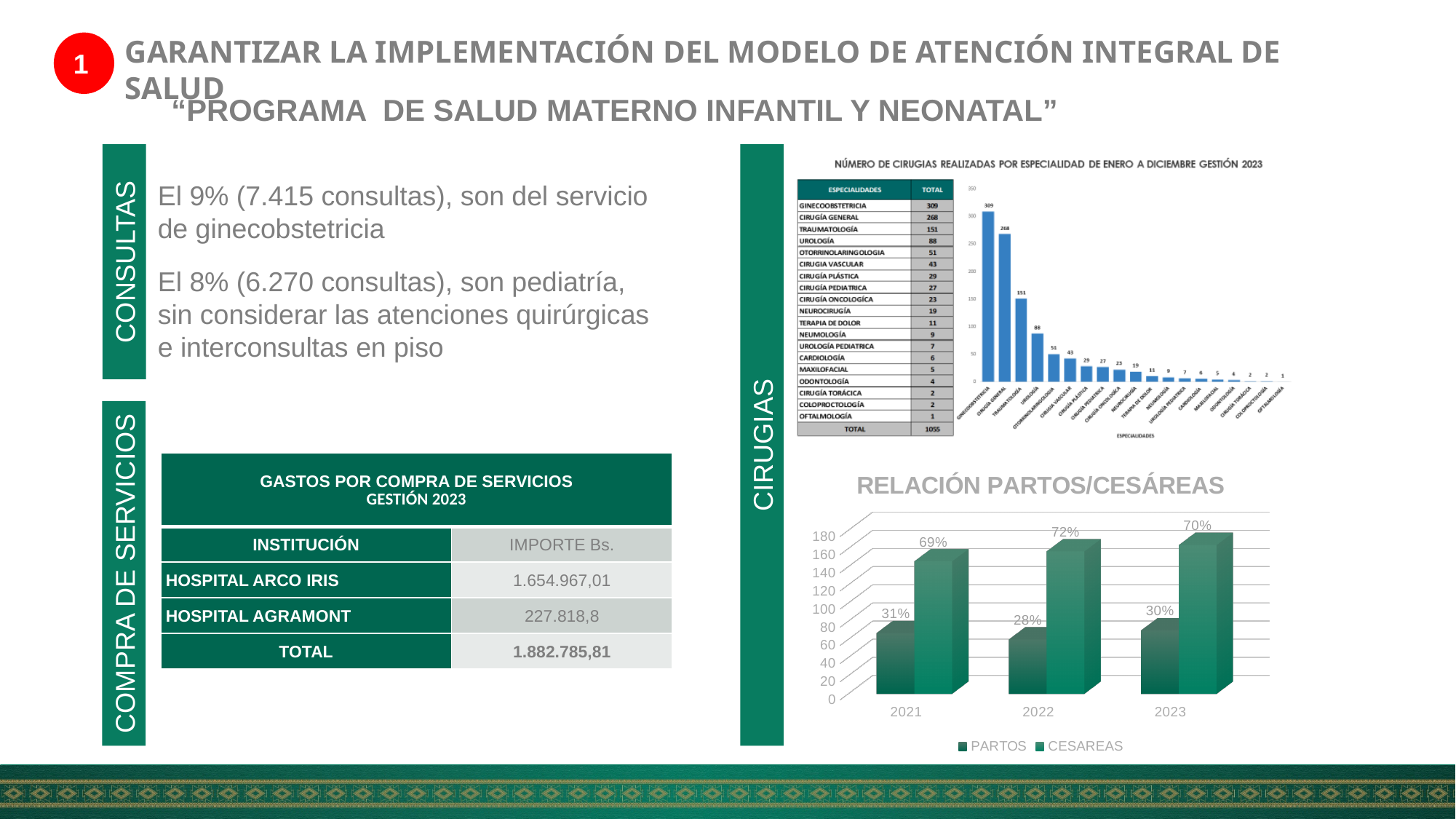
In the chart 'RELACIÓN PARTOS/CESÁREAS', how many series does the legend list? 2 In the chart 'RELACIÓN PARTOS/CESÁREAS', what is the data label for CESAREAS in 2022? 72% In the chart 'NÚMERO DE CIRUGIAS REALIZADAS POR ESPECIALIDAD DE ENERO A DICIEMBRE GESTIÓN 2023', which specialty has the highest value? GINECOOBSTETRICIA In the chart 'RELACIÓN PARTOS/CESÁREAS', what is the data label for PARTOS in 2023? 30% In the chart 'RELACIÓN PARTOS/CESÁREAS', what is the data label for PARTOS in 2021? 31% In the chart 'RELACIÓN PARTOS/CESÁREAS', which year has the lowest PARTOS label? 2022 In the chart 'NÚMERO DE CIRUGIAS REALIZADAS POR ESPECIALIDAD DE ENERO A DICIEMBRE GESTIÓN 2023', what is the difference between GINECOOBSTETRICIA and TRAUMATOLOGÍA? 158 In the chart 'NÚMERO DE CIRUGIAS REALIZADAS POR ESPECIALIDAD DE ENERO A DICIEMBRE GESTIÓN 2023', what is the value for CIRUGIA GENERAL? 268 In the chart 'NÚMERO DE CIRUGIAS REALIZADAS POR ESPECIALIDAD DE ENERO A DICIEMBRE GESTIÓN 2023', do the values rise or fall from left to right along the x axis? Fall In the chart 'RELACIÓN PARTOS/CESÁREAS', which is larger in 2023, PARTOS or CESAREAS? CESAREAS In the chart 'RELACIÓN PARTOS/CESÁREAS', how many years are shown on the x axis? 3 What kind of chart is 'RELACIÓN PARTOS/CESÁREAS'? Bar chart